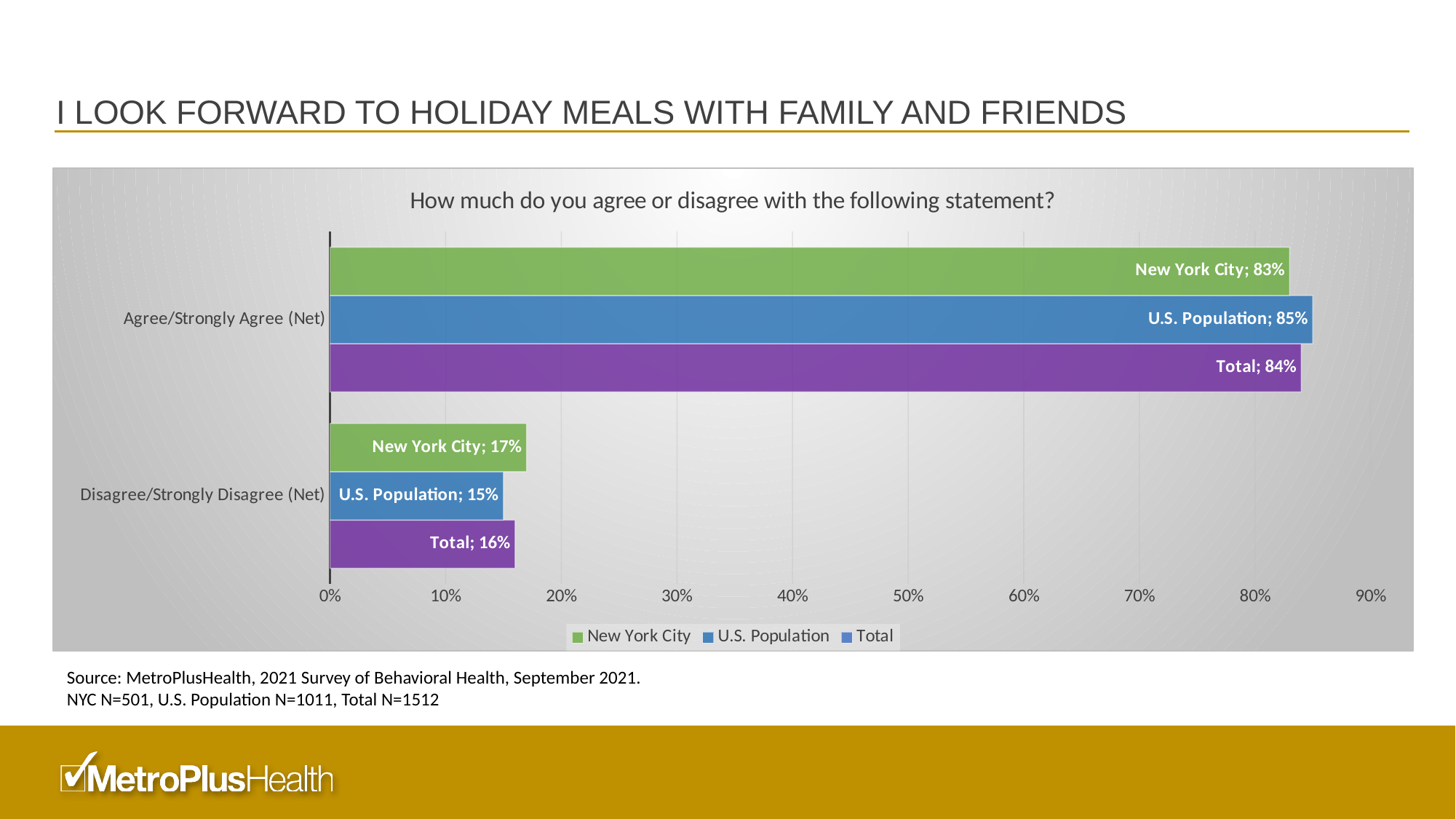
Which series has the highest value for Agree/Strongly Agree (Net)? U.S. Population What percentage of New York City respondents agree or strongly agree with the statement? 83% How many series does the legend list? 3 What kind of chart is shown on the slide? Bar chart What is the difference between the U.S. Population and New York City values for Agree/Strongly Agree (Net)? 2% For Disagree/Strongly Disagree (Net), which is larger: New York City or Total? New York City What percentage of the U.S. Population disagrees or strongly disagrees with the statement? 15% What is the title of the chart? How much do you agree or disagree with the following statement? Which series has the lowest value for Disagree/Strongly Disagree (Net)? U.S. Population How many categories are shown on the vertical axis? 2 What is the Total value for Disagree/Strongly Disagree (Net)? 16% What is the U.S. Population value for Agree/Strongly Agree (Net)? 85%